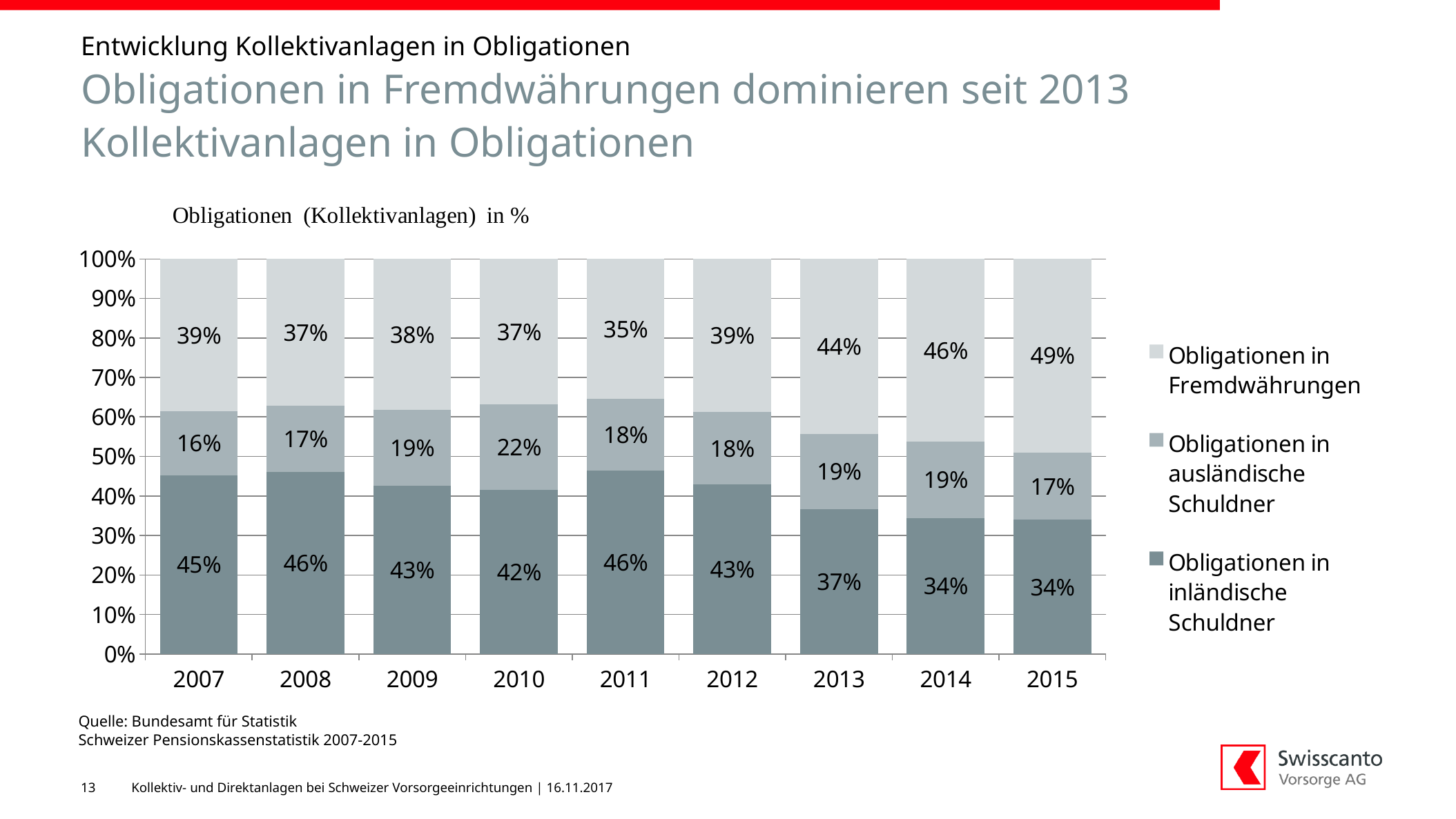
From 2012 to 2015, does the share of Obligationen in inländische Schuldner rise or fall? Fall In which year is the share of Obligationen in Fremdwährungen lowest? 2011 How many series does the legend list? 3 What is the value for Obligationen in ausländische Schuldner in 2010? 22% What is the value for Obligationen in Fremdwährungen in 2015? 49% In which year is the share of Obligationen in ausländische Schuldner highest? 2010 What is the difference between the Obligationen in Fremdwährungen share in 2015 and in 2007? 10% What is the value for Obligationen in inländische Schuldner in 2007? 45% How many years are shown on the x axis of the chart? 9 What kind of chart is shown on the slide? Stacked bar chart Which is larger in 2013: Obligationen in Fremdwährungen or Obligationen in inländische Schuldner? Obligationen in Fremdwährungen In which year is the share of Obligationen in Fremdwährungen highest? 2015